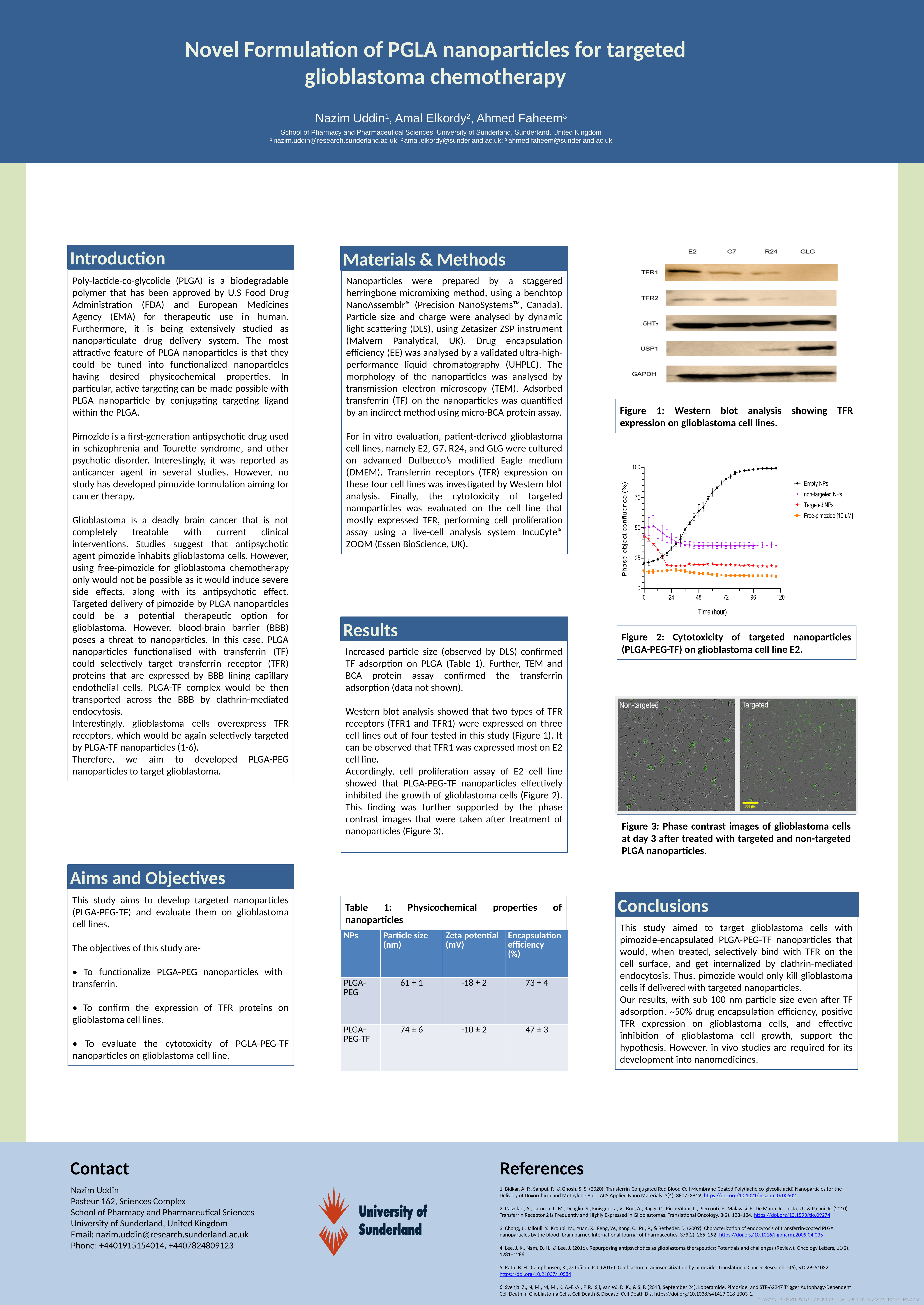
In the Figure 2 chart, does the Empty NPs series rise or fall over time? rise In the Figure 2 chart, which series has the lowest phase object confluence at 120 hours? Free-pimozide [10 uM] In the Figure 2 chart, is the value for non-targeted NPs at 120 hours greater or less than 50? less In the Figure 2 chart, at 120 hours, which is larger: non-targeted NPs or Targeted NPs? non-targeted NPs In the Figure 2 chart, is the value for Empty NPs at 120 hours greater or less than 75? greater In the Figure 2 chart, which series has the highest phase object confluence at 120 hours? Empty NPs What is the x-axis label of the Figure 2 chart? Time (hour) In the Figure 2 chart, is the value for Free-pimozide [10 uM] at 120 hours greater or less than 25? less What kind of chart is Figure 2 (Cytotoxicity of targeted nanoparticles on glioblastoma cell line E2)? line chart What is the y-axis label of the Figure 2 chart? Phase object confluence (%) In the Figure 2 chart, does the Targeted NPs series rise or fall over the first 24 hours? fall How many series does the legend of the Figure 2 chart list? 4